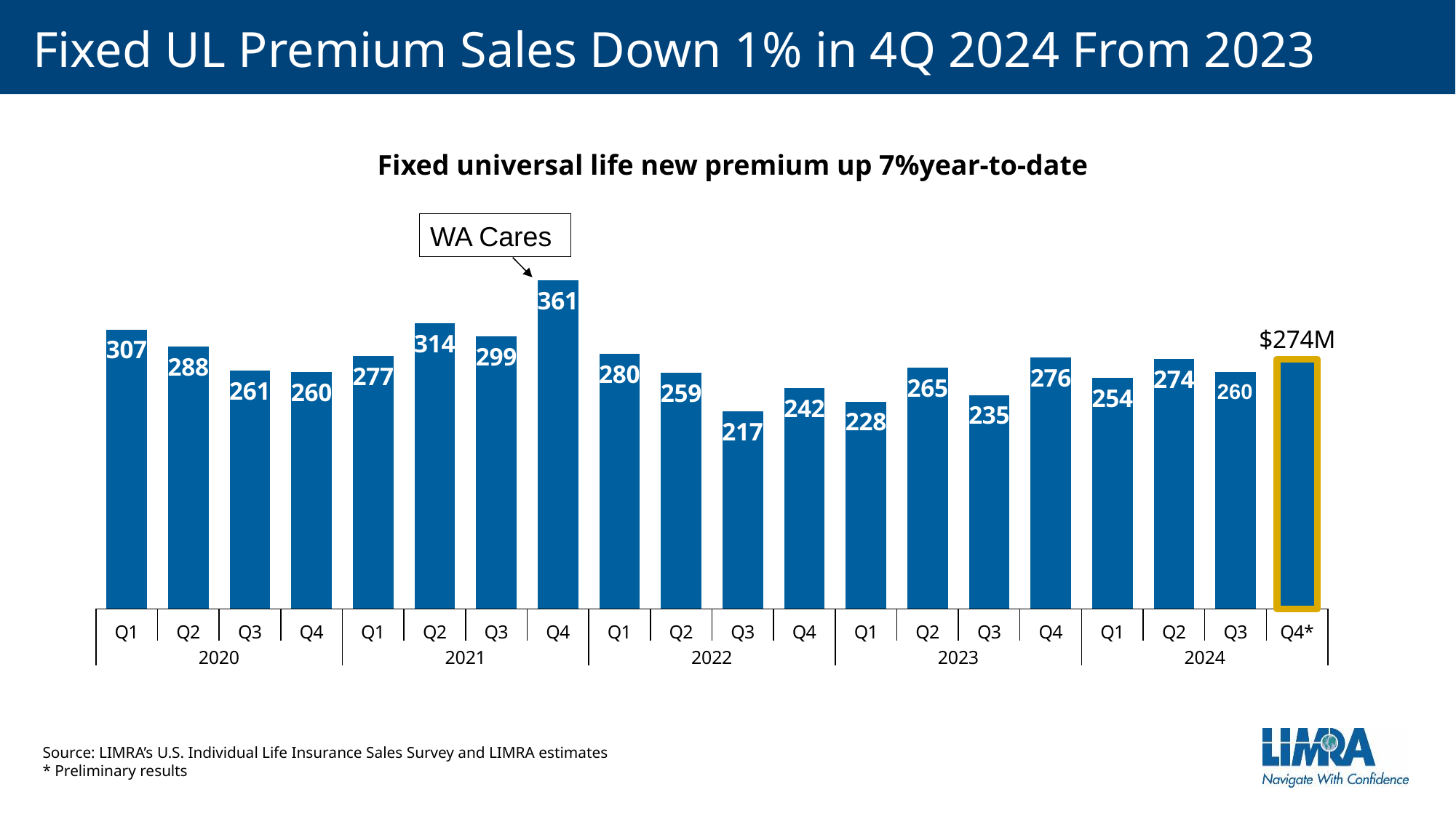
What is the value for Q3 2022? 217 What is the value for Q4 2021? 361 Which quarter has the highest value? Q4 2021 How many quarterly bars are plotted? 20 What is the chart's subtitle? Fixed universal life new premium up 7%year-to-date Do the values rise or fall from Q1 2022 to Q3 2022? Fall Which bar does the 'WA Cares' annotation point to? Q4 2021 Which quarter has the lowest value? Q3 2022 What is the value labelled for Q4* 2024? $274M What kind of chart is this? Bar chart Which is larger, Q1 2020 or Q1 2021? Q1 2020 What is the difference between Q4 2021 and Q3 2021? 62